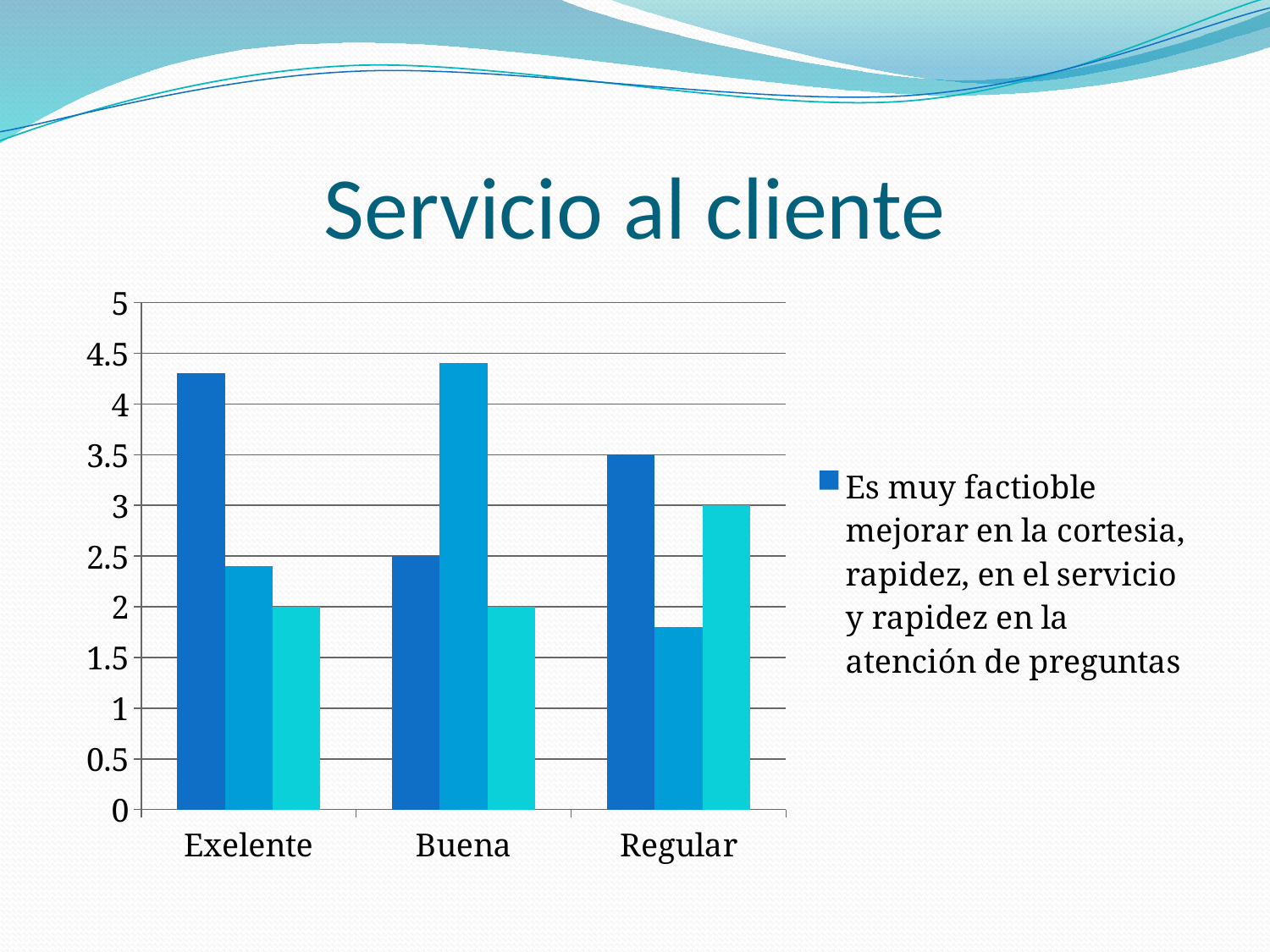
What kind of chart is shown on the slide? bar chart Is the value of the medium blue bar for Buena greater or less than 4? greater What is the value of the light cyan bar for Regular? 3 What is the value of the dark blue bar for Regular? 3.5 Is the value of the medium blue bar for Regular greater or less than 2? less What is the value of the light cyan bar for Exelente? 2 How many bars are plotted for each category in the chart? 3 How many categories are shown on the x axis of the chart? 3 Which category has the tallest dark blue bar? Exelente Which is larger: the dark blue bar for Buena or the dark blue bar for Regular? Regular Is the value of the dark blue bar for Exelente greater or less than 4? greater Which category has the lowest medium blue bar? Regular